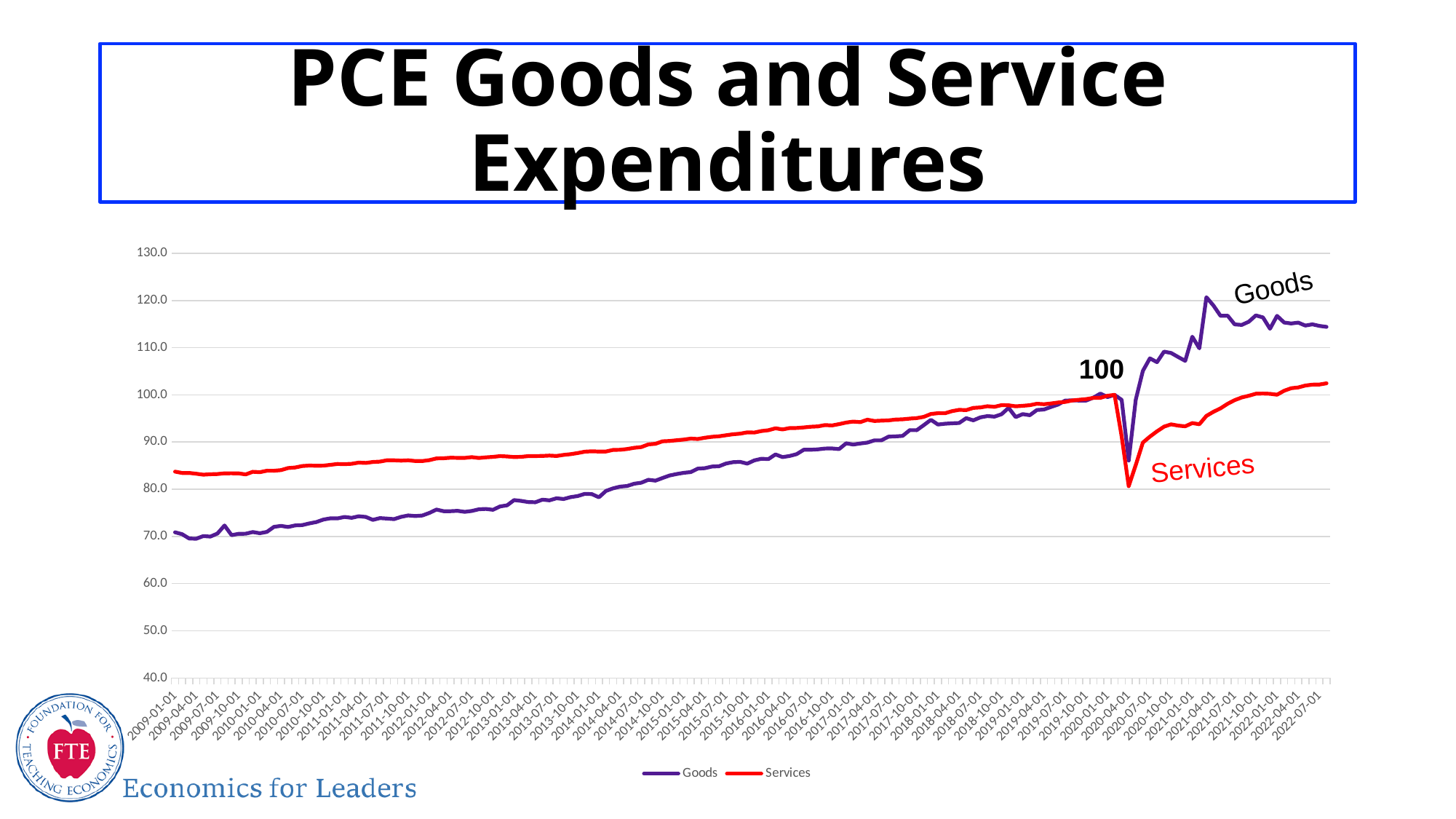
How many series does the legend list? 2 At 2009-01-01, which series has the higher value, Goods or Services? Services What is the title of the chart on the slide? PCE Goods and Service Expenditures Is the value for Goods at 2022-07-01 greater or less than 110? greater What are the two series named in the legend? Goods and Services What value is annotated on the chart where the Goods and Services lines meet around 2020-01-01? 100 At 2022-07-01, which series has the higher value, Goods or Services? Goods Is the value for Goods at 2009-01-01 greater or less than 80? less Is the lowest value of Services during the 2020 dip greater or less than 90? less Does the Goods series generally rise or fall from 2009-01-01 to 2019-10-01? rise What kind of chart is shown on the slide? line chart